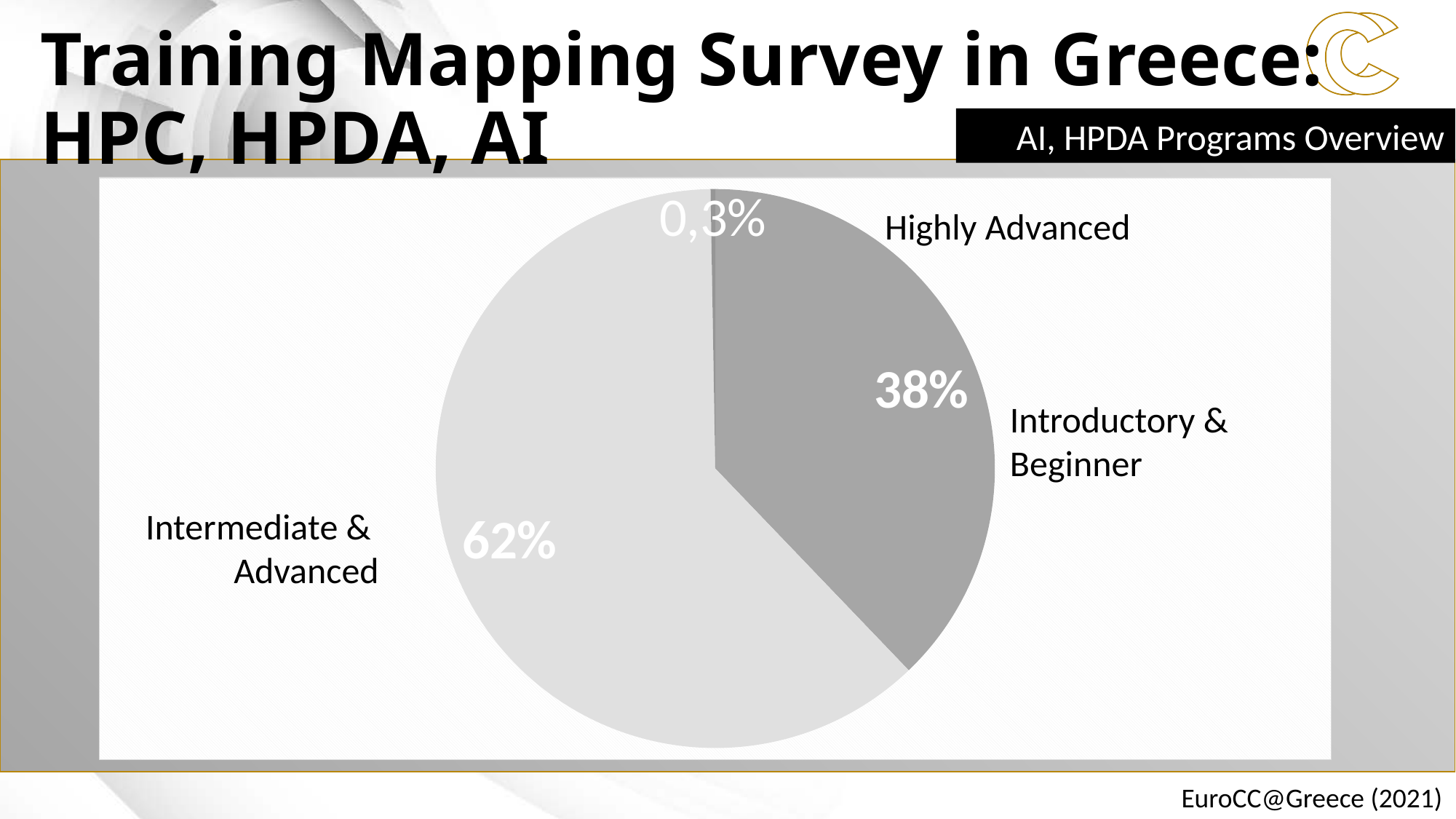
Which is larger, the share for Introductory & Beginner or the share for Highly Advanced? Introductory & Beginner What is the text in the black box at the top right of the slide? AI, HPDA Programs Overview What share of the pie does Intermediate & Advanced hold? 62% What kind of chart is shown on the slide? pie chart Which is larger, the share for Intermediate & Advanced or the share for Introductory & Beginner? Intermediate & Advanced How many categories are shown in the pie chart? 3 What share of the pie does Highly Advanced hold? 0,3% Which category has the largest slice of the pie? Intermediate & Advanced Which category has the smallest slice of the pie? Highly Advanced What is the difference in percentage points between Intermediate & Advanced and Introductory & Beginner? 24 What share of the pie does Introductory & Beginner hold? 38% What is the title of the slide? Training Mapping Survey in Greece: HPC, HPDA, AI